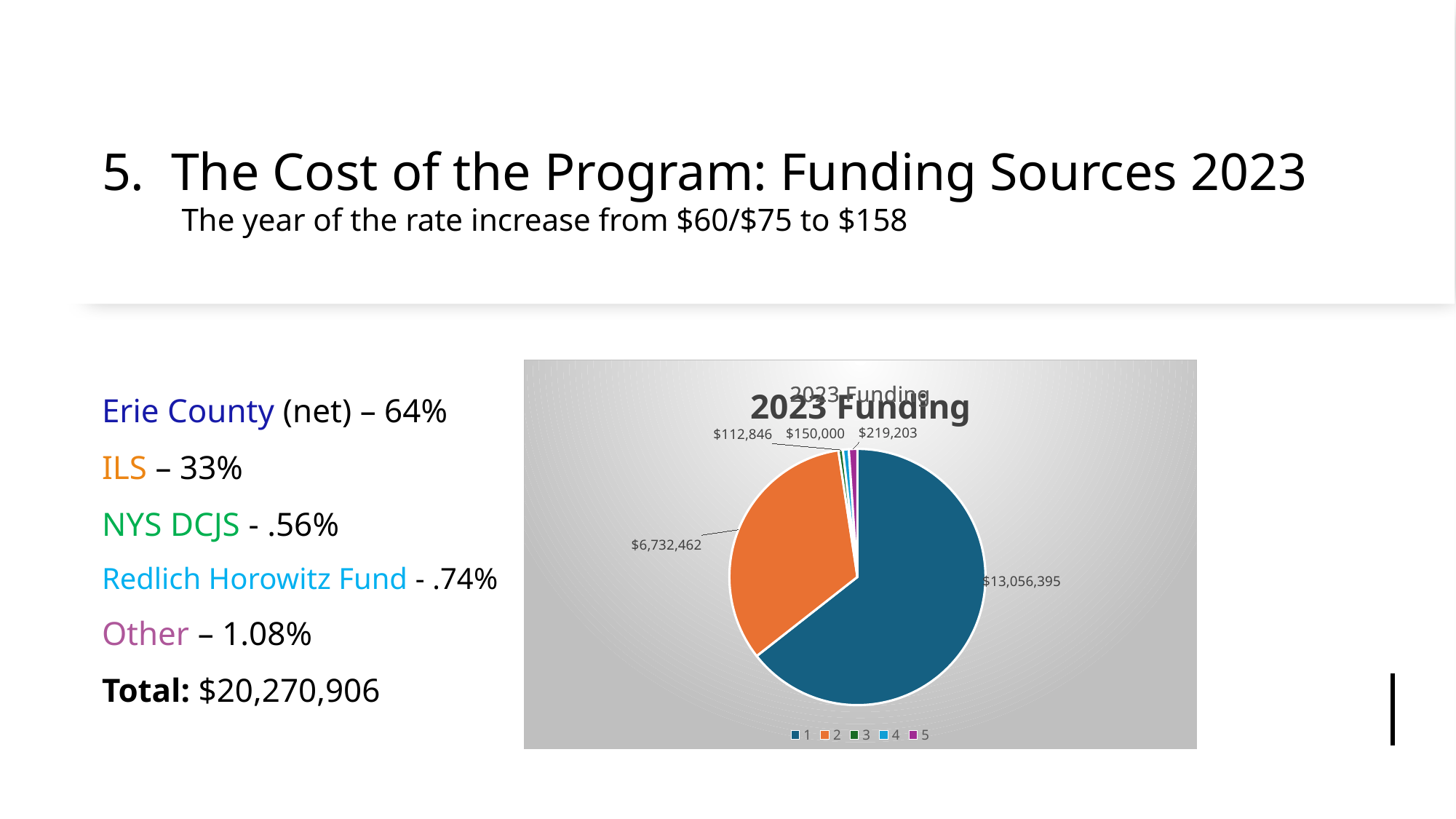
What share of the total funding does the largest slice (Erie County net) represent? 64% What is the difference between the two largest slices, $13,056,395 and $6,732,462? $6,323,933 What is the value of the orange slice (legend entry 2)? $6,732,462 Which is larger, the slice labeled $150,000 or the slice labeled $219,203? $219,203 How many entries does the chart legend list? 5 What is the total of all the slice values shown in the pie chart? $20,270,906 What is the value of the dark blue slice (legend entry 1)? $13,056,395 What is the value of the largest slice in the pie chart? $13,056,395 What is the title of the chart? 2023 Funding What is the value of the smallest slice in the pie chart? $112,846 What kind of chart is shown on the slide? pie chart How many slices does the pie chart have? 5